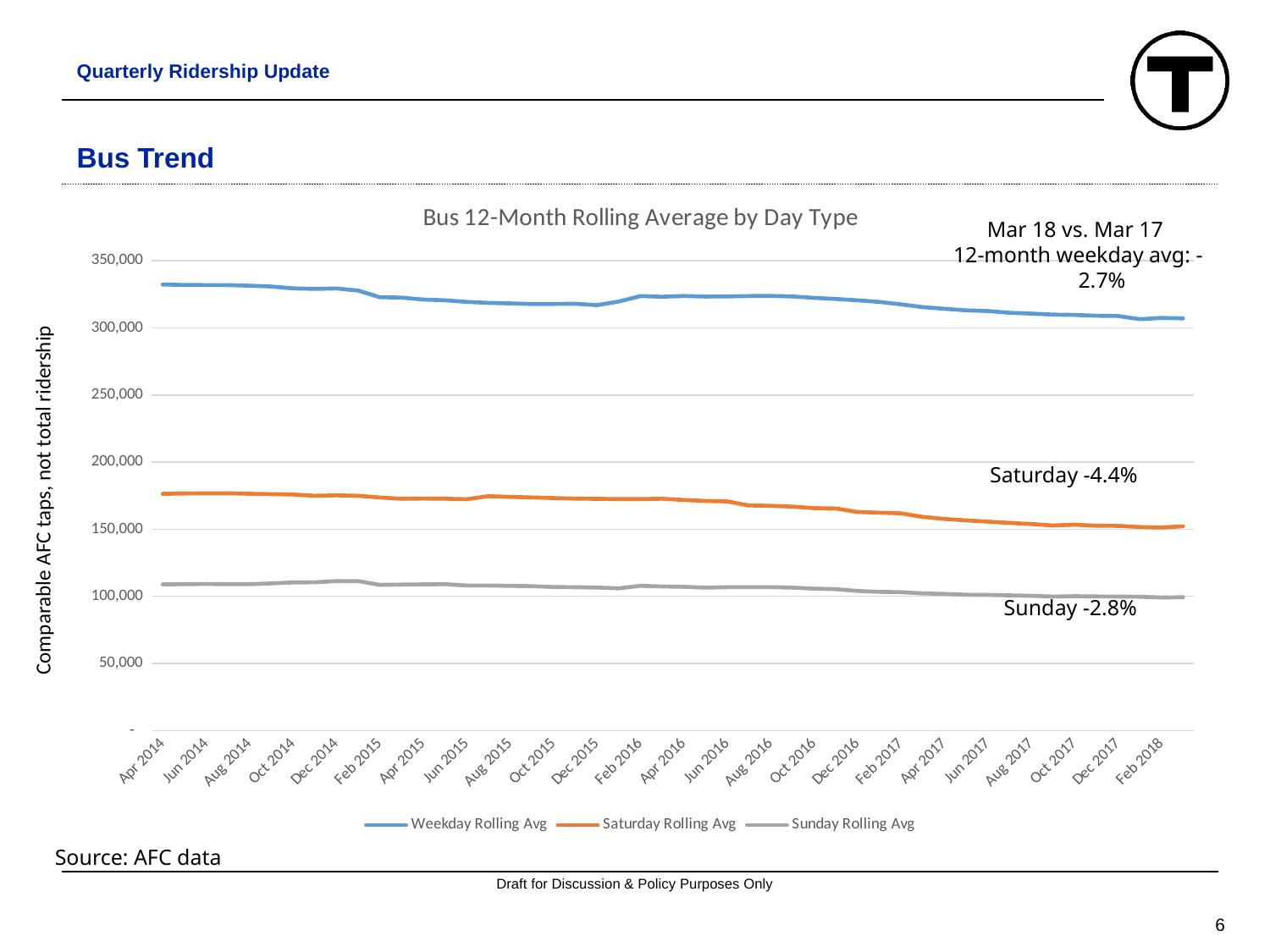
How many series does the chart legend list? 3 What percentage change is shown for the Sunday 12-month average, Mar 18 vs. Mar 17? -2.8% At Feb 2018, which is larger: the Saturday Rolling Avg or the Sunday Rolling Avg? Saturday Rolling Avg Which series has the highest values throughout the chart? Weekday Rolling Avg Is the Weekday Rolling Avg value for Apr 2014 greater or less than 300,000? greater What kind of chart is shown on the slide? Line chart Which series has the lowest values throughout the chart? Sunday Rolling Avg Does the Weekday Rolling Avg line rise or fall from Apr 2014 to Feb 2018? Fall Is the Sunday Rolling Avg value for Apr 2014 greater or less than 150,000? less Is the Saturday Rolling Avg value for Apr 2014 greater or less than 200,000? less What is the title of the chart? Bus 12-Month Rolling Average by Day Type What percentage change is shown for the Saturday 12-month average, Mar 18 vs. Mar 17? -4.4%